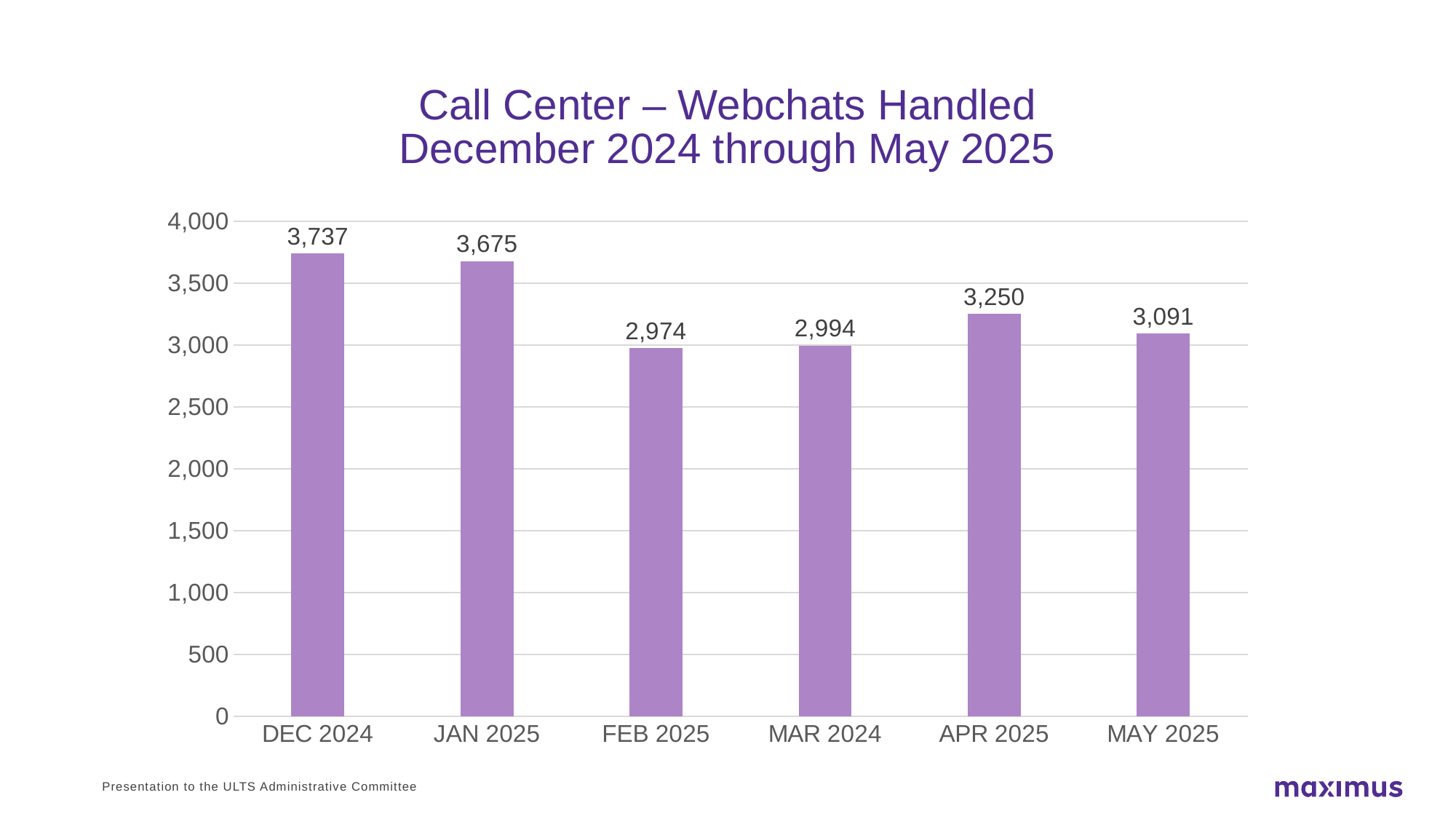
What kind of chart is shown on the slide? bar chart What is the title of the chart? Call Center – Webchats Handled December 2024 through May 2025 What is the value shown for APR 2025? 3,250 What is the difference between the values for APR 2025 and MAY 2025? 159 How many webchats were handled in DEC 2024? 3,737 What is the difference between the values for DEC 2024 and JAN 2025? 62 Which month has the lowest number of webchats handled? FEB 2025 Which month has the highest number of webchats handled? DEC 2024 How many months are shown on the x axis? 6 What is the value shown for MAY 2025? 3,091 Which is larger, the value for JAN 2025 or the value for APR 2025? JAN 2025 Is the value for FEB 2025 greater or less than 3,000? less